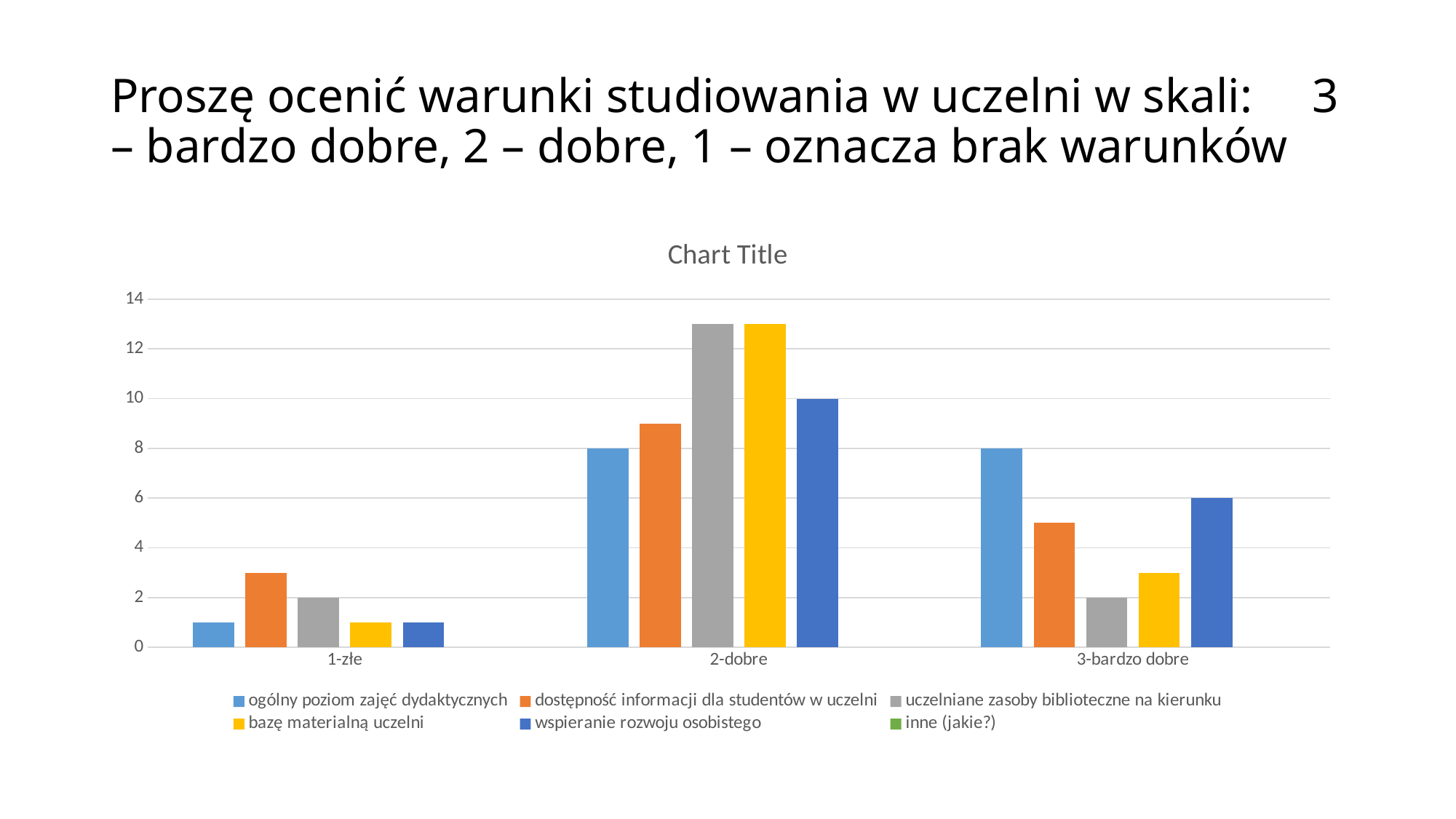
What type of chart is shown on the slide? bar chart Is the value for 'dostępność informacji dla studentów w uczelni' in the '3-bardzo dobre' category greater or less than 4? greater Which series has the lowest value in the '2-dobre' category? ogólny poziom zajęć dydaktycznych What is the difference between 'wspieranie rozwoju osobistego' and 'ogólny poziom zajęć dydaktycznych' in the '2-dobre' category? 2 What is the value for 'wspieranie rozwoju osobistego' in the '3-bardzo dobre' category? 6 How many series does the legend list? 6 What is the value for 'wspieranie rozwoju osobistego' in the '2-dobre' category? 10 What is the value for 'uczelniane zasoby biblioteczne na kierunku' in the '1-złe' category? 2 How many categories are shown on the x axis? 3 Is the value for 'uczelniane zasoby biblioteczne na kierunku' in the '2-dobre' category greater or less than 12? greater What is the value for 'ogólny poziom zajęć dydaktycznych' in the '2-dobre' category? 8 Which series has the highest value in the '3-bardzo dobre' category? ogólny poziom zajęć dydaktycznych